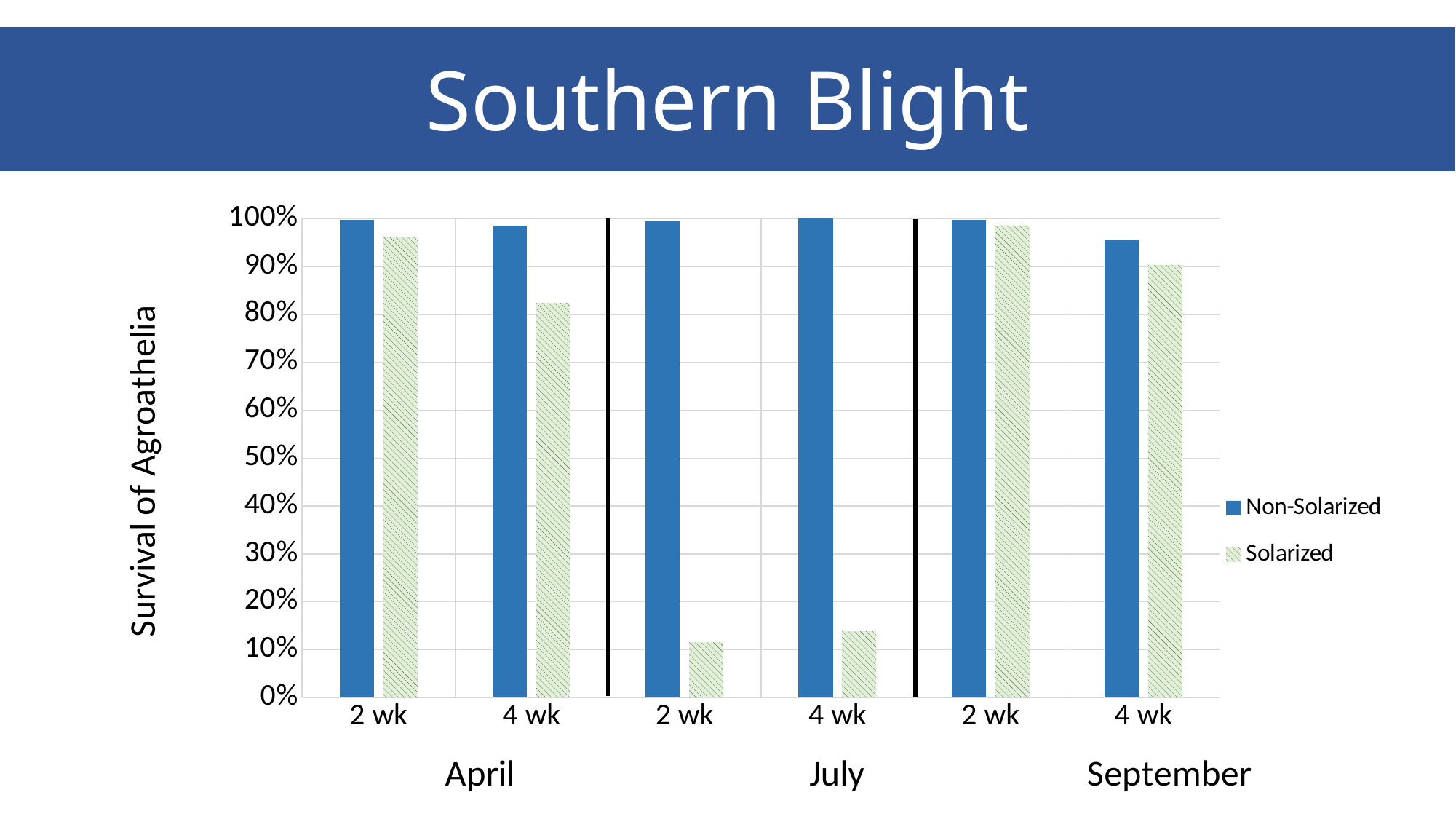
In which month is the Solarized survival lowest? July Which months are shown along the x axis? April, July, September Is the Solarized value for July 4 wk greater or less than 30%? less For April 4 wk, which is larger: Non-Solarized or Solarized? Non-Solarized Is the Non-Solarized value for September 4 wk greater or less than 90%? greater How many bars are plotted for the Solarized series? 6 What is the y-axis label of the chart? Survival of Agroathelia How many series does the legend list? 2 What kind of chart is shown on the slide? bar chart Is the Solarized value for July 2 wk greater or less than 20%? less Does the Solarized value rise or fall from 2 wk to 4 wk in April? fall